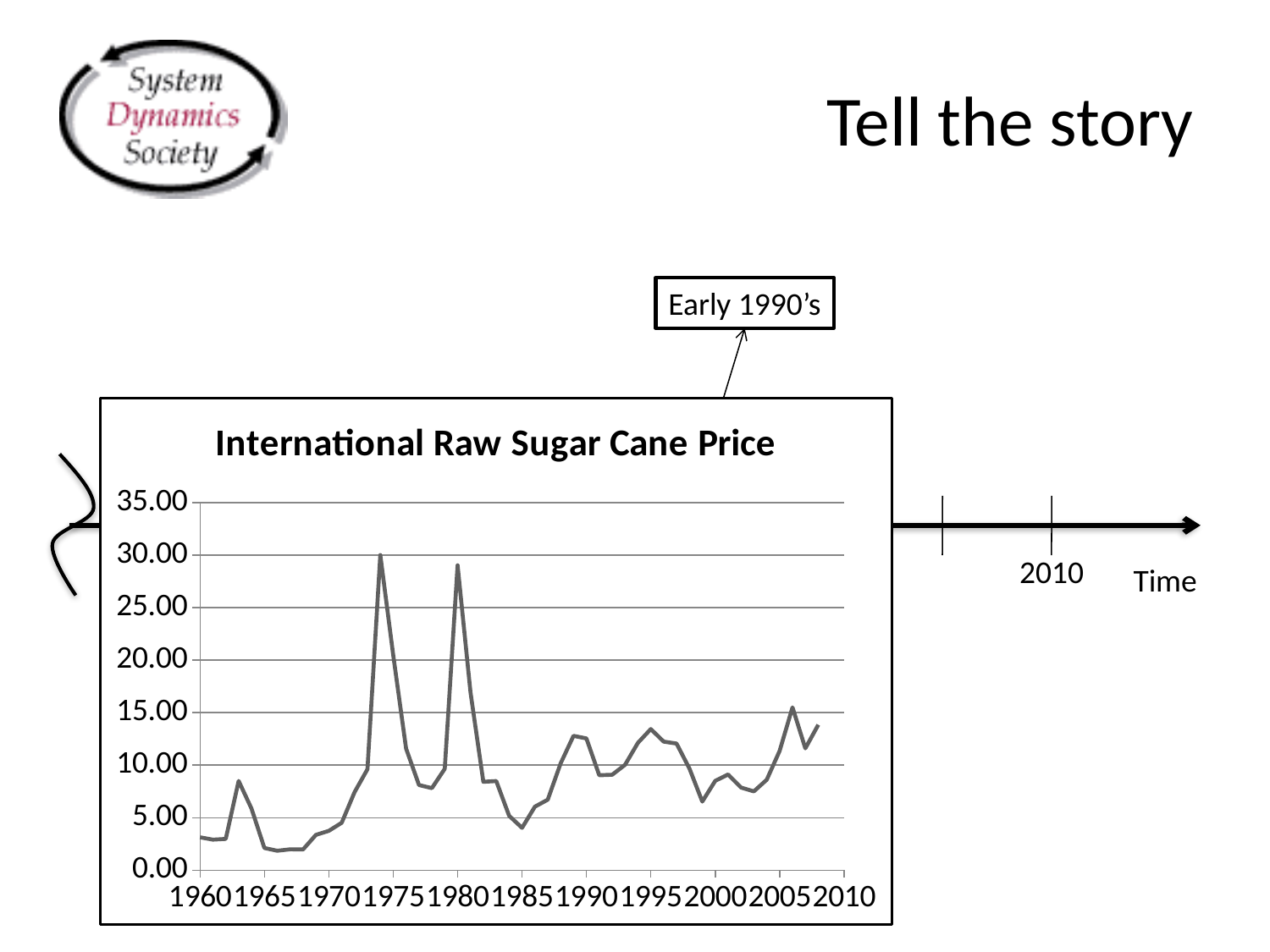
What is the highest value labelled on the y axis of the chart? 35.00 Is the value for 2000 greater or less than 10.00? less Is the value for 1985 greater or less than 5.00? less Does the price rise or fall between 1995 and 2000? fall Is the value for 1990 greater or less than 10.00? greater How many year labels are shown on the x axis of the chart? 11 How many lines are plotted on the chart? 1 What is the title of the chart? International Raw Sugar Cane Price What type of chart is shown on the slide? line chart